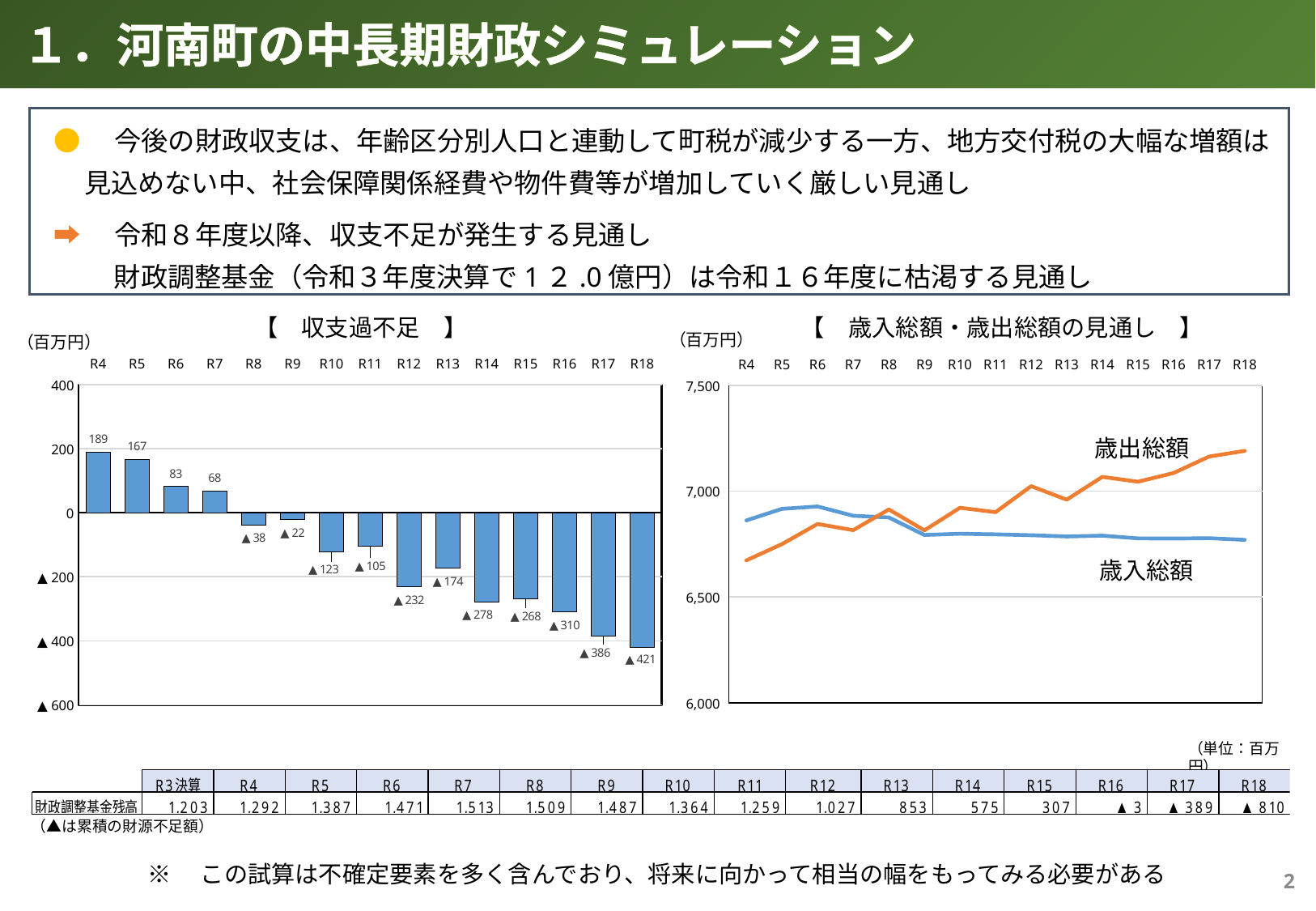
In the 歳入総額・歳出総額の見通し chart, is the value of 歳出総額 at R18 greater or less than 7,000? greater How many years are plotted in the 収支過不足 chart? 15 In the 収支過不足 chart, which year has the lowest value? R18 In the 歳入総額・歳出総額の見通し chart, which series is higher at R18, 歳出総額 or 歳入総額? 歳出総額 In the 収支過不足 chart, which is larger, the value for R6 or the value for R7? R6 In the 収支過不足 chart, which year has the highest value? R4 In the 収支過不足 chart, what is the value for R4? 189 In the 収支過不足 chart, what is the difference between the values for R4 and R5? 22 What kind of chart is the 収支過不足 chart? bar chart In the 収支過不足 chart, what is the value for R12? ▲232 What kind of chart is the 歳入総額・歳出総額の見通し chart? line chart In the 収支過不足 chart, what is the value for R18? ▲421